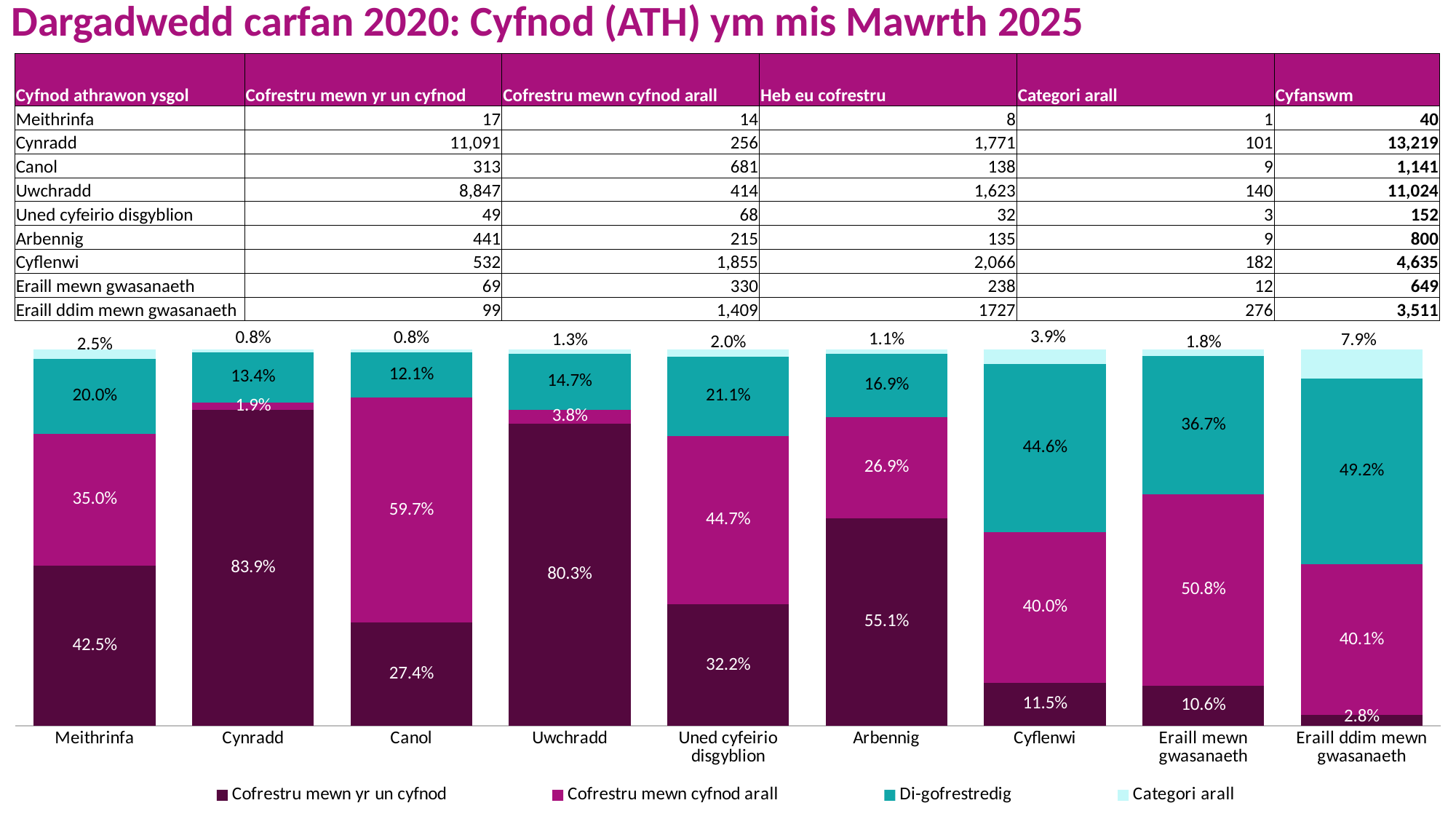
How many categories are shown on the x axis of the chart? 9 In the chart, which is larger: the 'Di-gofrestredig' value for Meithrinfa or for Uned cyfeirio disgyblion? Uned cyfeirio disgyblion In the chart, what is the 'Di-gofrestredig' value for Cyflenwi? 44.6% Which series in the chart legend is shown in the lightest colour? Categori arall Which category has the highest 'Cofrestru mewn yr un cyfnod' share in the chart? Cynradd What kind of chart is shown below the table? stacked bar chart In the chart, what is the 'Categori arall' value for Eraill ddim mewn gwasanaeth? 7.9% In the chart, what is the difference between the 'Cofrestru mewn yr un cyfnod' values for Uwchradd and Arbennig? 25.2% Which category has the lowest 'Cofrestru mewn yr un cyfnod' share in the chart? Eraill ddim mewn gwasanaeth How many series does the chart legend list? 4 In the chart, what is the 'Cofrestru mewn cyfnod arall' value for Canol? 59.7% In the chart, what is the 'Cofrestru mewn yr un cyfnod' value for Cynradd? 83.9%